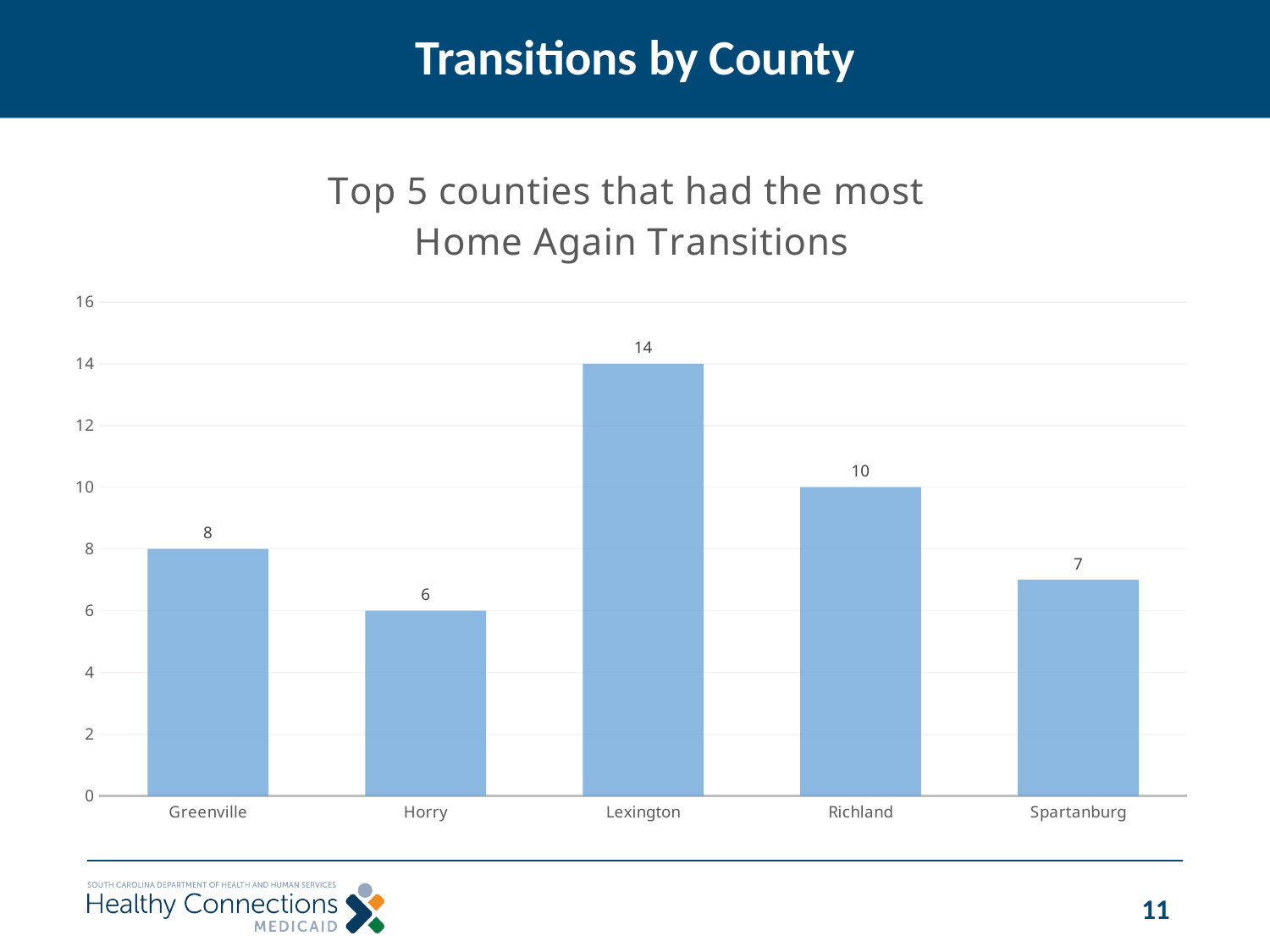
What is the title of the chart? Top 5 counties that had the most Home Again Transitions What kind of chart is shown on the slide? Bar chart Is the value for Richland greater or less than 8? greater Which is larger, the value for Greenville or the value for Spartanburg? Greenville What is the difference between the values for Greenville and Horry? 2 How many counties are shown in the chart? 5 What is the value for Lexington? 14 Which county has the highest number of Home Again Transitions? Lexington What is the value for Spartanburg? 7 What is the difference between the values for Lexington and Richland? 4 Which county has the lowest number of Home Again Transitions? Horry What is the value for Horry? 6